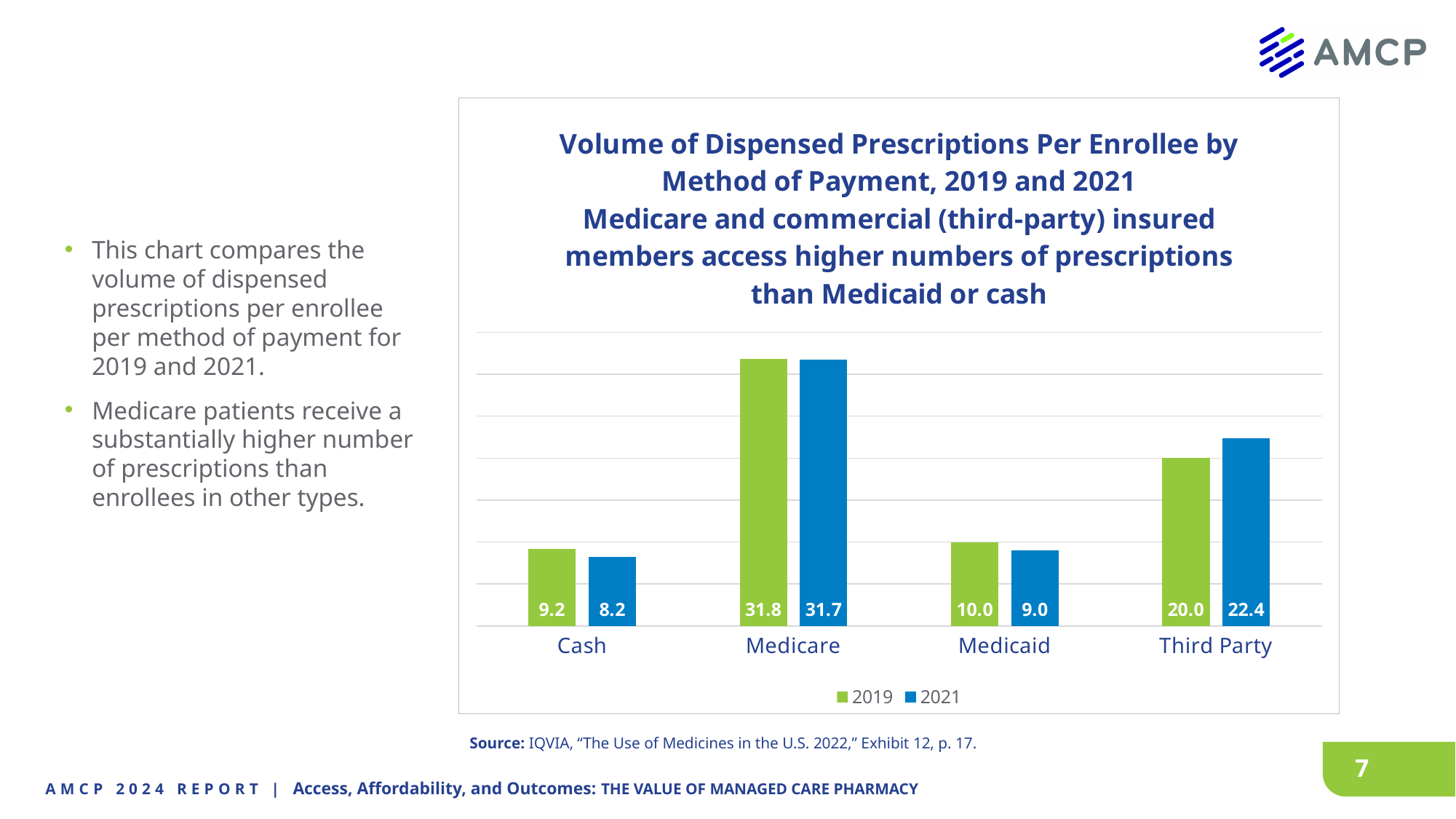
Which method of payment has the lowest value in 2019? Cash Which is larger for Medicaid: the 2019 value or the 2021 value? 2019 What is the difference between the 2019 values for Medicaid and Cash? 0.8 What is the volume of dispensed prescriptions per enrollee for Medicare in 2019? 31.8 What kind of chart is shown on the slide? Bar chart What is the value for Cash in 2021? 8.2 How many methods of payment are shown on the x axis? 4 Which method of payment has the highest value in 2021? Medicare How many series does the legend list? 2 Which colour represents the 2021 series in the chart? Blue What is the difference between the 2021 and 2019 values for Third Party? 2.4 What is the value for Third Party in 2021? 22.4